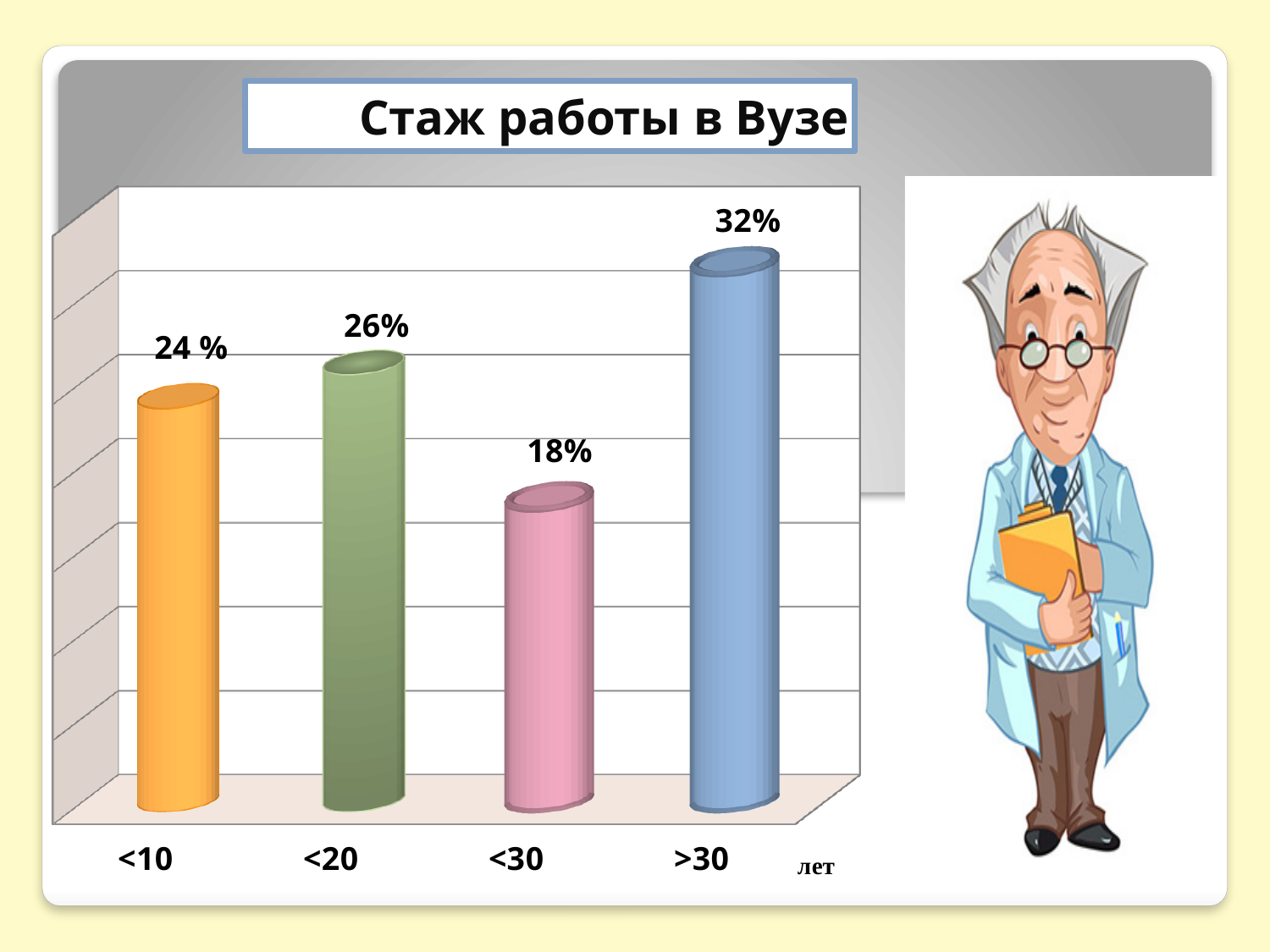
Which category has the highest value? >30 What is the value for the <30 category? 18% What kind of chart is shown on the slide? Bar chart How many categories are shown on the chart? 4 What is the value for the <10 category? 24 % What is the title of the chart? Стаж работы в Вузе What is the value for the <20 category? 26% What is the difference between the values for >30 and <30? 14% Which is larger, the value for <20 or the value for <30? <20 What is the difference between the values for <20 and <10? 2% What is the value for the >30 category? 32% Which category has the lowest value? <30